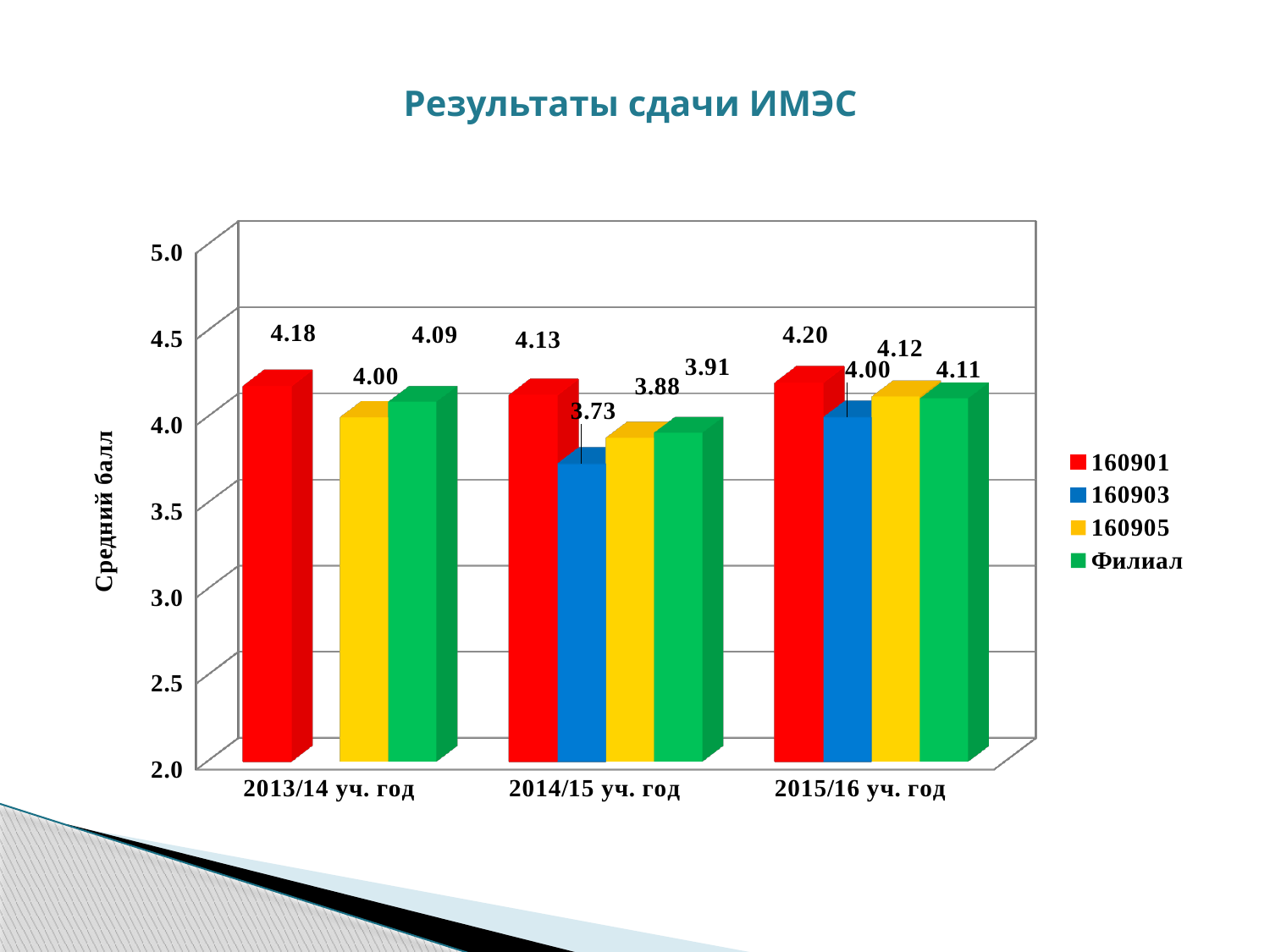
How many series does the legend list? 4 What is the value for 160905 in 2014/15 уч. год? 3.88 What kind of chart is shown on the slide? Bar chart What is the difference between the 160901 value and the 160903 value in 2014/15 уч. год? 0.40 Which is larger: the 160905 value in 2015/16 уч. год or the Филиал value in 2015/16 уч. год? 160905 What is the value for 160901 in 2013/14 уч. год? 4.18 What is the value for Филиал in 2015/16 уч. год? 4.11 How many categories are shown on the x axis? 3 Which series has the highest value in 2015/16 уч. год? 160901 Does the value for 160901 rise or fall from 2014/15 уч. год to 2015/16 уч. год? Rise What is the value for 160903 in 2014/15 уч. год? 3.73 Which series has the lowest value in 2014/15 уч. год? 160903